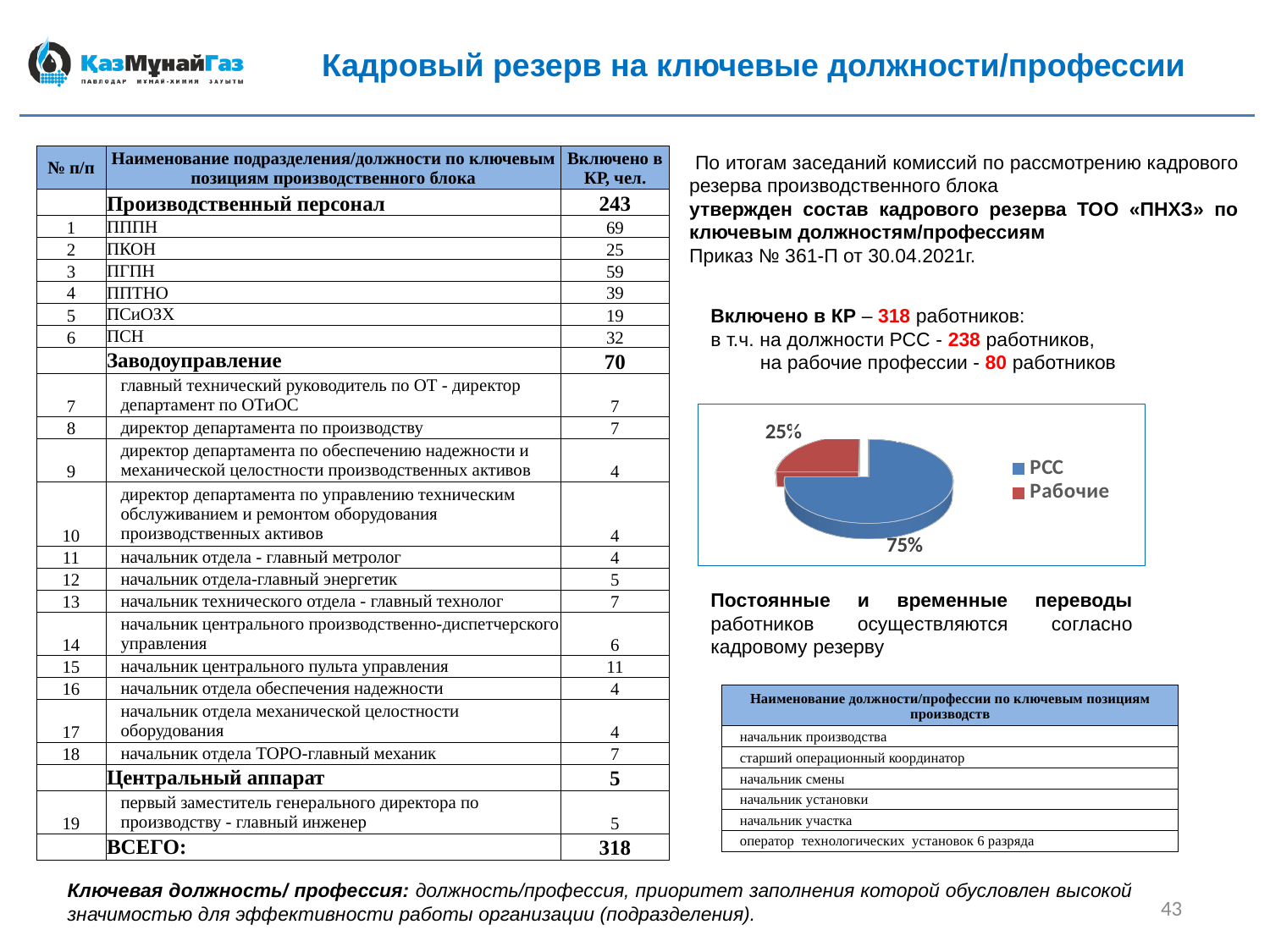
How many slices does the pie chart have? 2 Which category has the smallest slice in the pie chart? Рабочие What percentage of the pie chart is labelled for РСС? 75% What kind of chart is shown on the slide? Pie chart What colour is the Рабочие slice in the pie chart? Red What share of the pie chart does Рабочие represent? 25% What colour is the РСС slice in the pie chart? Blue Which slice is larger in the pie chart, РСС or Рабочие? РСС Which category has the largest slice in the pie chart? РСС How many entries does the legend of the pie chart list? 2 By how many percentage points does the РСС slice exceed the Рабочие slice in the pie chart? 50 percentage points What percentage of the pie chart is labelled for Рабочие? 25%